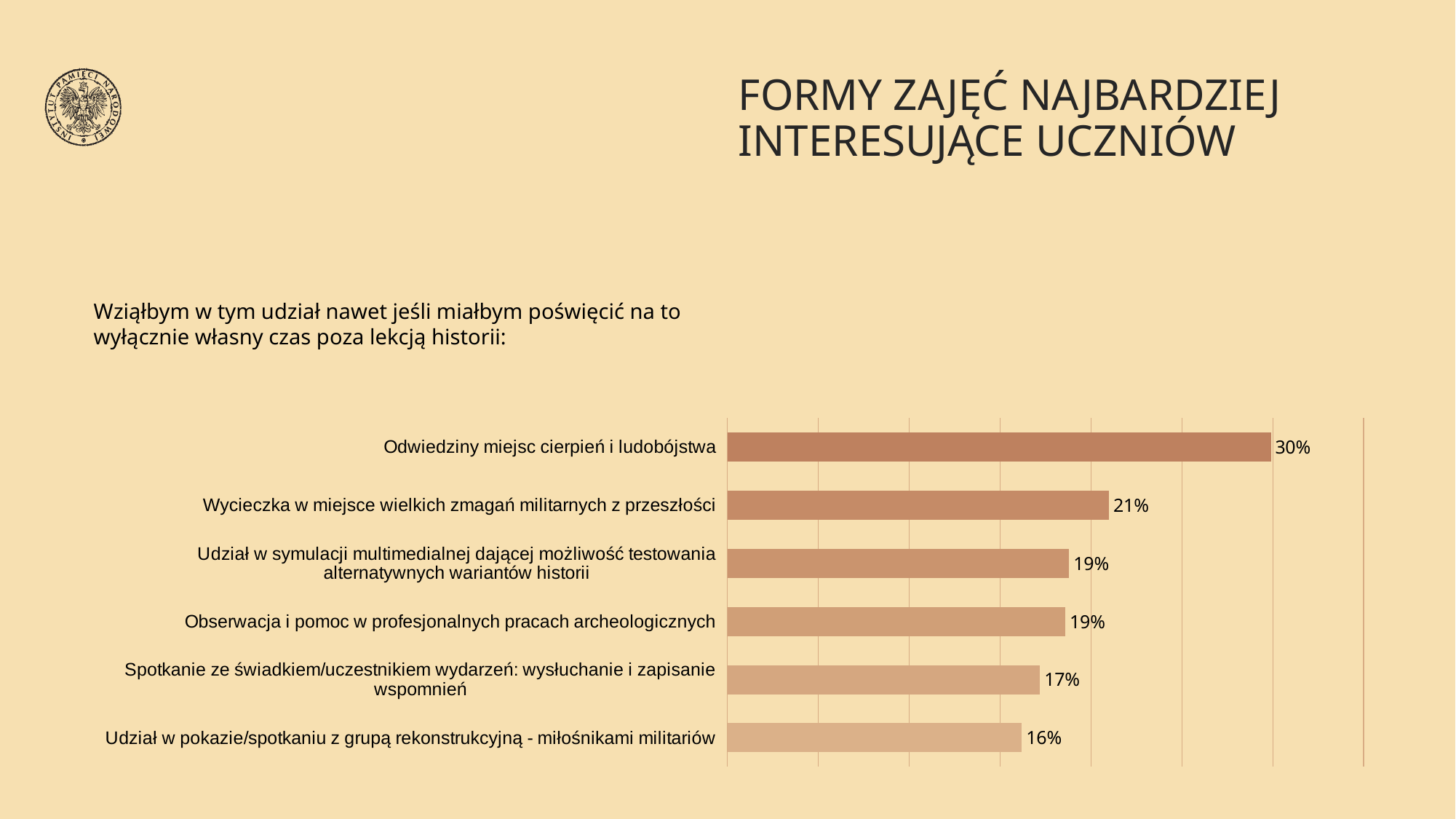
What is the value for "Obserwacja i pomoc w profesjonalnych pracach archeologicznych"? 19% Which category has the lowest value? Udział w pokazie/spotkaniu z grupą rekonstrukcyjną - miłośnikami militariów How many categories does the chart show? 6 What is the difference between the values for "Odwiedziny miejsc cierpień i ludobójstwa" and "Wycieczka w miejsce wielkich zmagań militarnych z przeszłości"? 9% What is the value for "Udział w pokazie/spotkaniu z grupą rekonstrukcyjną - miłośnikami militariów"? 16% Which category has the highest value? Odwiedziny miejsc cierpień i ludobójstwa What is the title of the slide containing the chart? FORMY ZAJĘĆ NAJBARDZIEJ INTERESUJĄCE UCZNIÓW What is the value for "Odwiedziny miejsc cierpień i ludobójstwa"? 30% What type of chart is shown on the slide? bar chart Which is larger: the value for "Wycieczka w miejsce wielkich zmagań militarnych z przeszłości" or the value for "Spotkanie ze świadkiem/uczestnikiem wydarzeń: wysłuchanie i zapisanie wspomnień"? Wycieczka w miejsce wielkich zmagań militarnych z przeszłości What is the value for "Spotkanie ze świadkiem/uczestnikiem wydarzeń: wysłuchanie i zapisanie wspomnień"? 17% What is the value for "Wycieczka w miejsce wielkich zmagań militarnych z przeszłości"? 21%